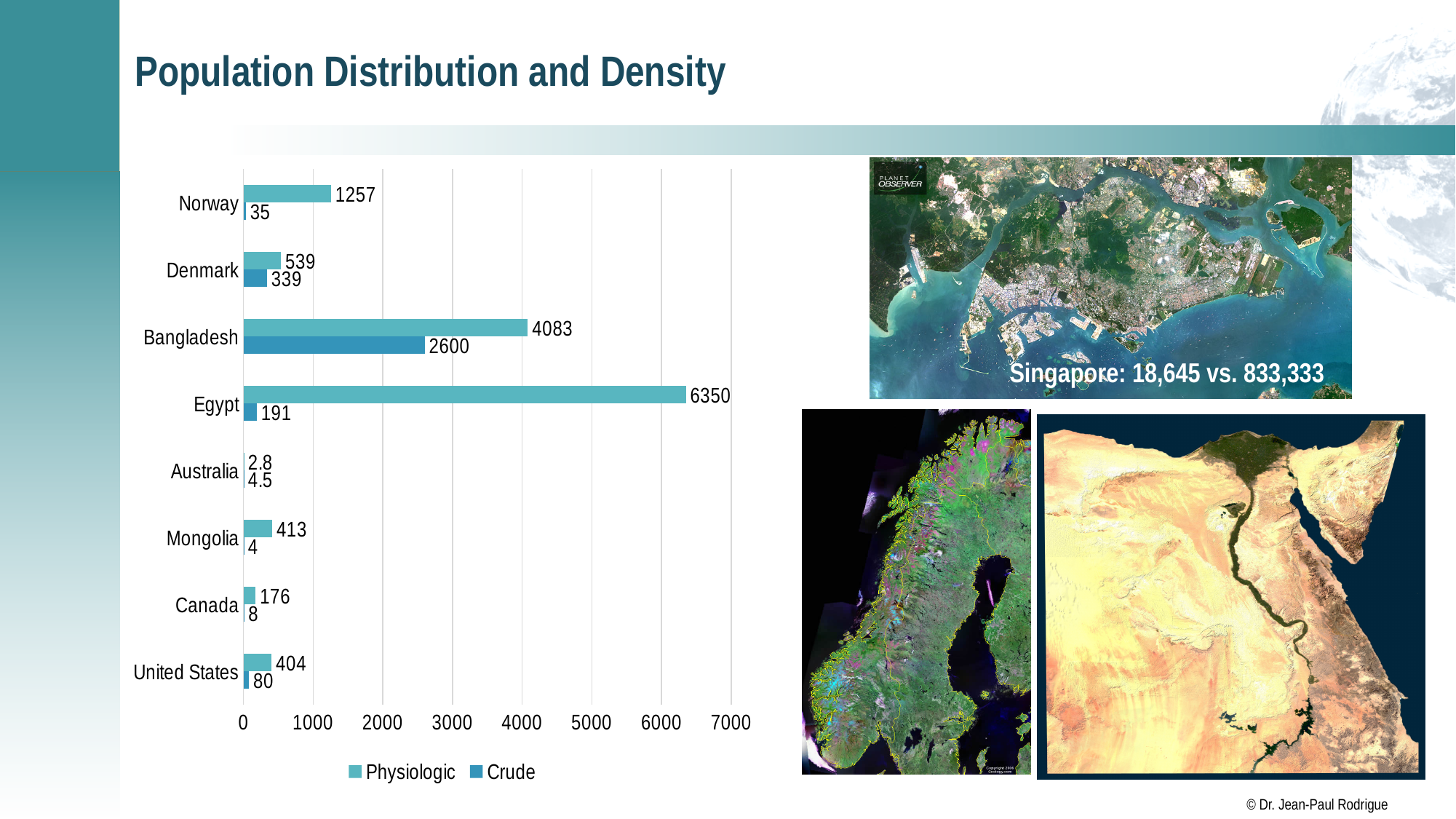
Which is larger, the Physiologic density of Denmark or the Physiologic density of the United States? Denmark Is the Physiologic density value for Bangladesh greater or less than 4000? greater How many countries are shown on the chart? 8 What is the difference between the Physiologic and Crude density values for Bangladesh? 1483 How many series does the legend list? 2 What is the Physiologic density value for Mongolia? 413 What is the Crude density value for Bangladesh? 2600 What is the Crude density value for Norway? 35 What kind of chart is shown on the slide? Bar chart Which country has the highest Physiologic density? Egypt Which country has the lowest Physiologic density? Australia What is the Physiologic density value for Egypt? 6350